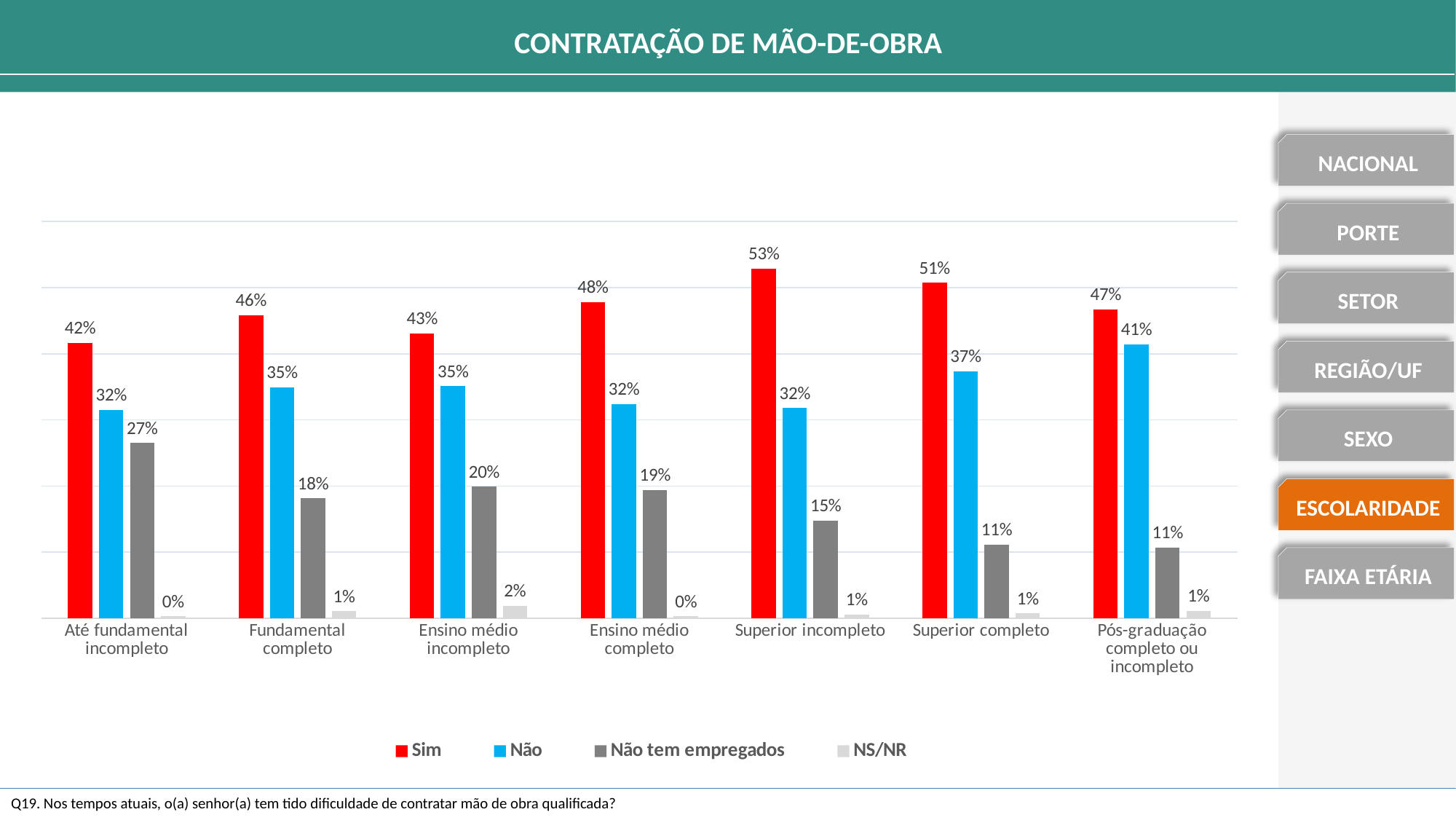
Which category has the lowest value for the "Sim" series? Até fundamental incompleto What is the difference between the "Sim" and "Não" values for "Superior incompleto"? 21% Which colour represents the "Sim" series in the legend? Red Which category has the highest value for the "Sim" series? Superior incompleto How many education categories are shown on the x axis? 7 What kind of chart is shown on the slide? Bar chart How many series does the legend list? 4 What is the value of the "Não" series for "Pós-graduação completo ou incompleto"? 41% Does the "Não tem empregados" series generally rise or fall from "Até fundamental incompleto" to "Superior completo"? Fall What is the value of the "Não tem empregados" series for "Até fundamental incompleto"? 27% Which is larger for "Superior completo": the "Não" value or the "Não tem empregados" value? Não What is the value of the "Sim" series for "Superior incompleto"? 53%